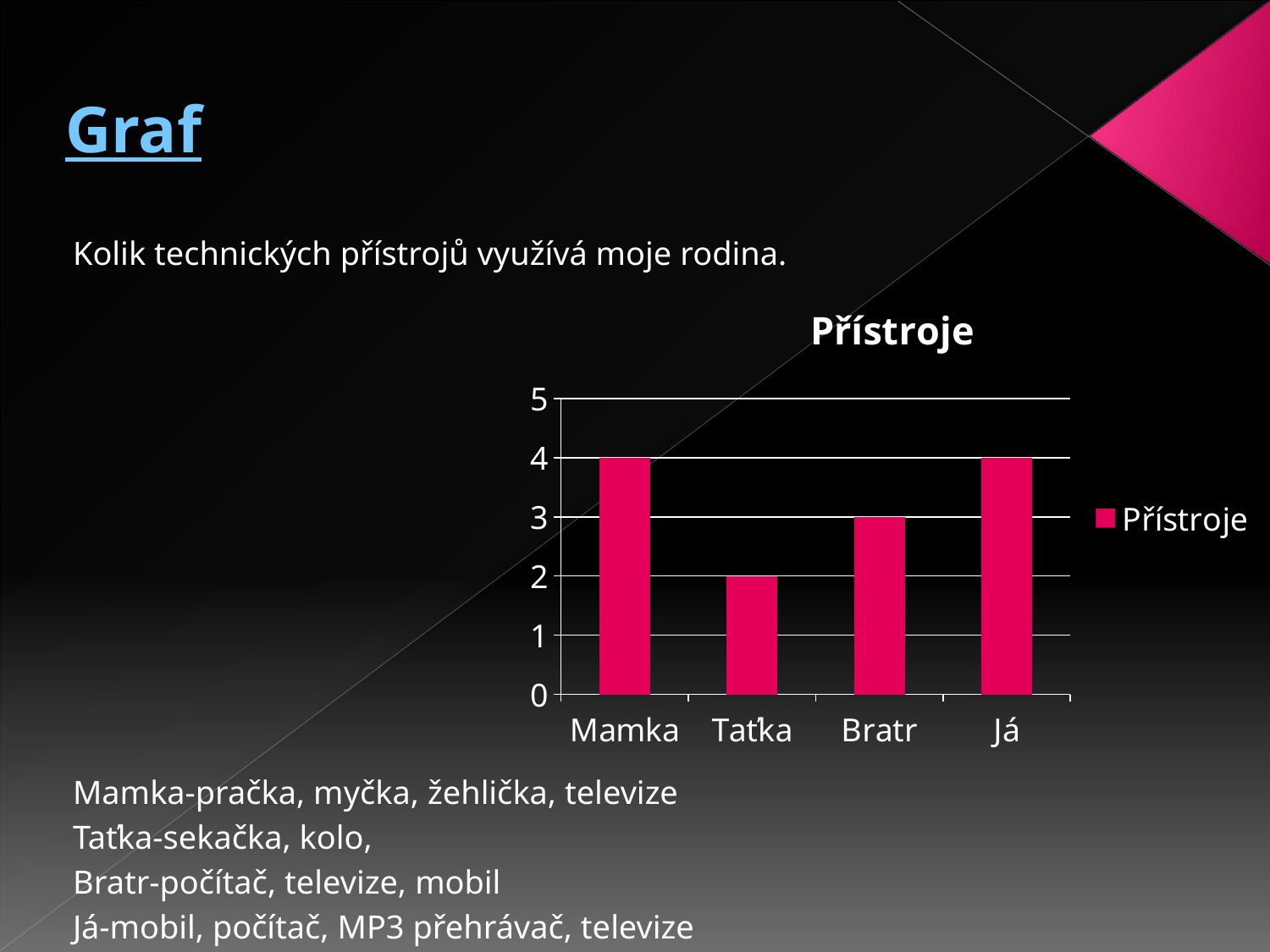
What is the difference between the values for Bratr and Taťka? 1 Which is larger, the value for Bratr or the value for Taťka? Bratr What is the value for Já in the Přístroje chart? 4 How many series does the legend list? 1 What is the value for Bratr in the Přístroje chart? 3 What is the difference between the values for Mamka and Taťka? 2 How many categories are shown on the x axis of the chart? 4 Is the value for Bratr greater or less than 2? greater Which category has the lowest value in the Přístroje chart? Taťka What is the value for Mamka in the Přístroje chart? 4 What is the value for Taťka in the Přístroje chart? 2 What kind of chart is shown on the slide? bar chart